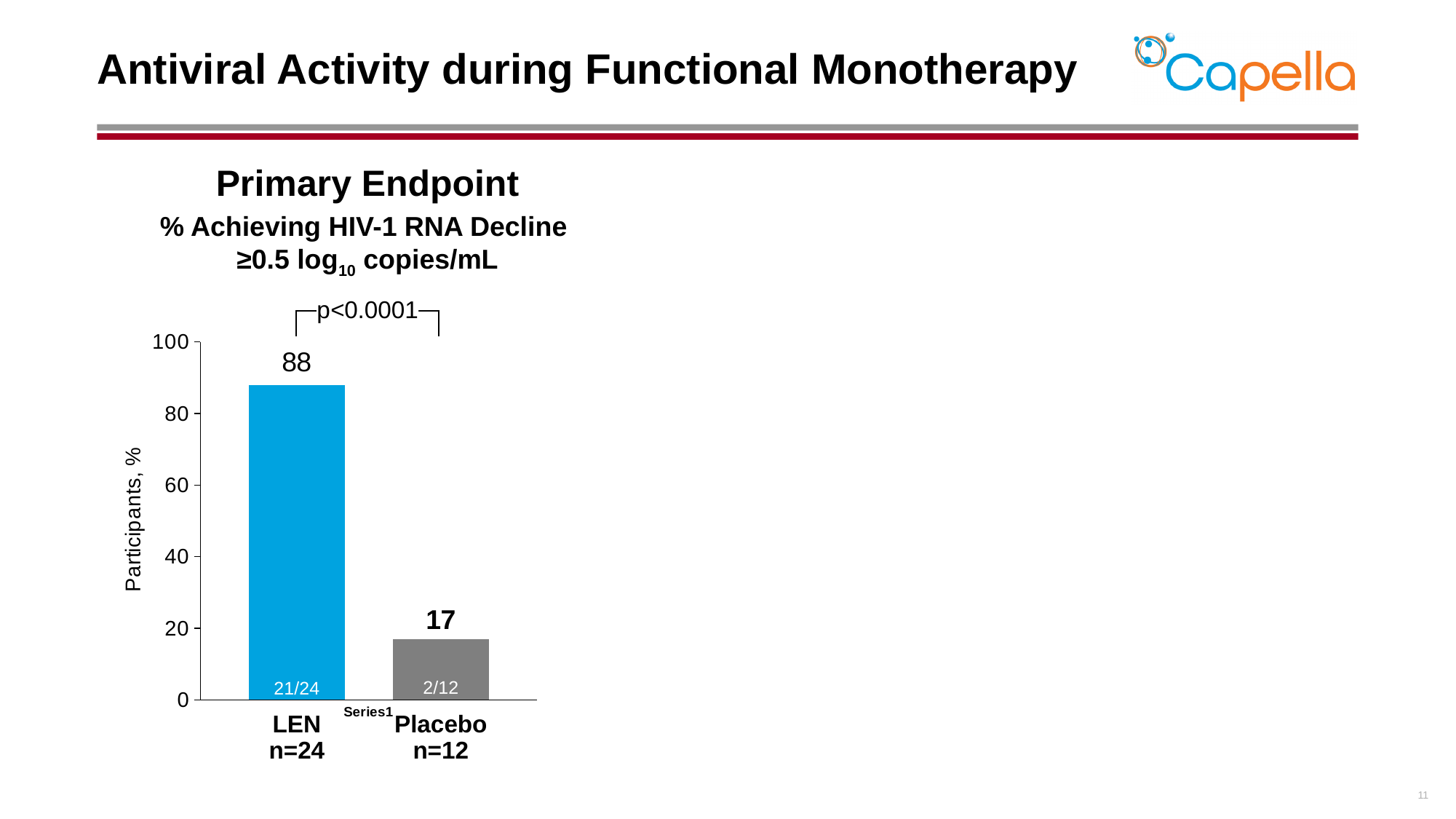
What percentage of participants in the Placebo group achieved an HIV-1 RNA decline of ≥0.5 log10 copies/mL? 17 How many participants in the LEN group achieved the endpoint, as shown inside the bar? 21/24 What percentage of participants in the LEN group achieved an HIV-1 RNA decline of ≥0.5 log10 copies/mL? 88 What p-value is shown above the bars? p<0.0001 Is the value for the LEN group greater or less than 80? greater What is the difference in percentage points between the LEN and Placebo groups? 71 Is the value for the Placebo group greater or less than 20? less What kind of chart is shown on the slide? Bar chart Which group has the lower percentage of participants achieving the primary endpoint? Placebo Which group has the higher percentage of participants achieving the primary endpoint? LEN How many participants in the Placebo group achieved the endpoint, as shown inside the bar? 2/12 How many groups are shown in the chart? 2